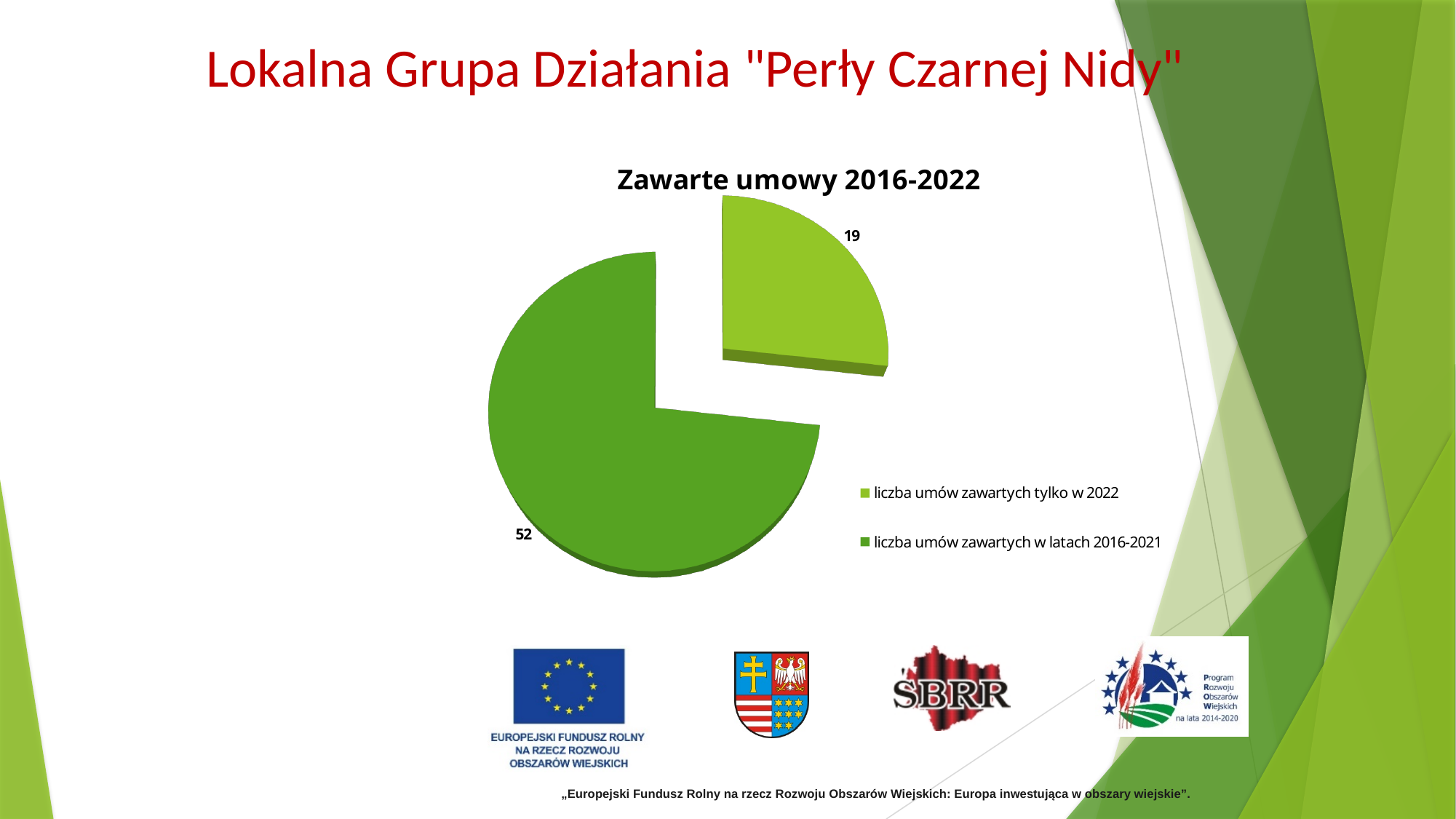
Which category has the smallest slice of the pie? liczba umów zawartych tylko w 2022 What is the value for "liczba umów zawartych w latach 2016-2021"? 52 Which category has the largest slice of the pie? liczba umów zawartych w latach 2016-2021 What is the title of the chart? Zawarte umowy 2016-2022 What is the difference between the number of contracts concluded in 2016-2021 and those concluded only in 2022? 33 Which is larger: the value for contracts concluded only in 2022 or the value for contracts concluded in 2016-2021? liczba umów zawartych w latach 2016-2021 What type of chart is shown on the slide? pie chart What is the total of the two values shown in the pie chart? 71 What is the value for "liczba umów zawartych tylko w 2022"? 19 Which colour represents "liczba umów zawartych tylko w 2022" in the chart? light green How many entries does the legend list? 2 How many slices does the pie chart have? 2